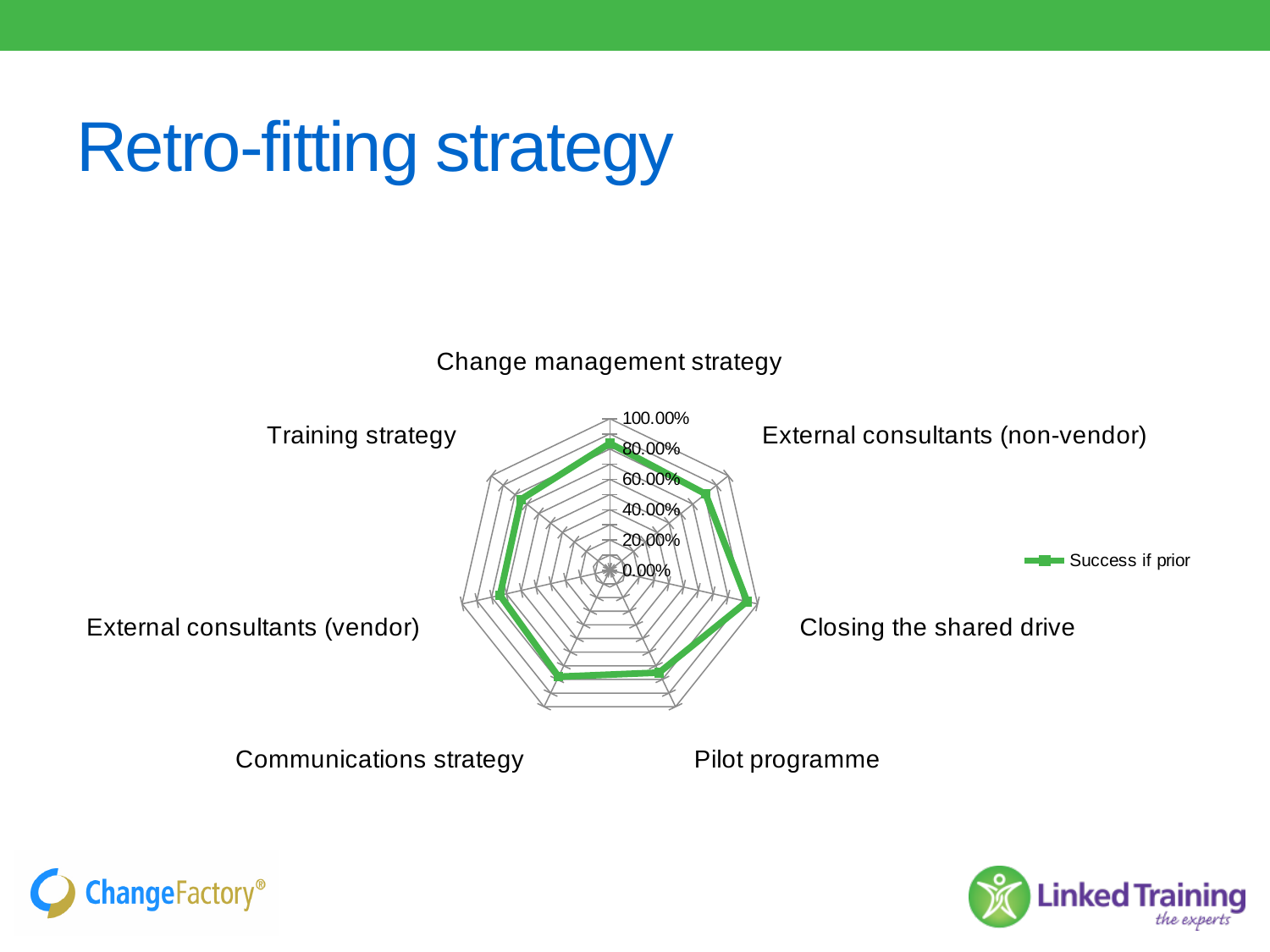
What is the name of the series shown in the legend? Success if prior Is the value for Closing the shared drive greater or less than 80.00%? greater How many series does the legend list? 1 What colour is the plotted line for the 'Success if prior' series? Green Which has the larger value: Change management strategy or External consultants (vendor)? Change management strategy Is the value for External consultants (vendor) greater or less than 80.00%? less Is the value for Training strategy greater or less than 60.00%? greater Which has the larger value: Closing the shared drive or External consultants (vendor)? Closing the shared drive How many categories (axes) does the radar chart have? 7 What kind of chart is shown on the slide? Radar chart